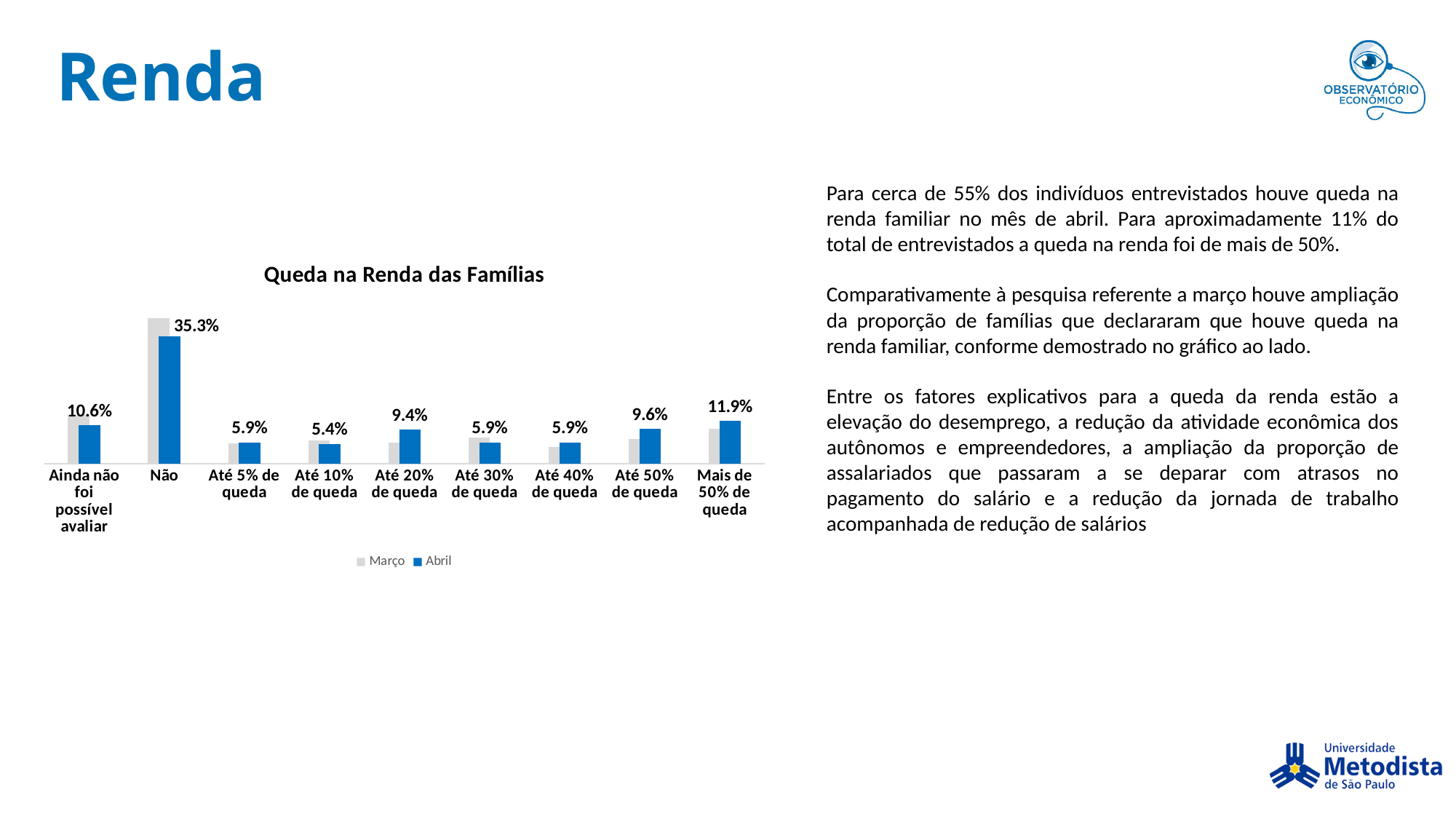
Which category has the lowest Abril value? Até 10% de queda Which has a larger Abril value: "Até 50% de queda" or "Até 20% de queda"? Até 50% de queda How many categories are shown on the x axis of the chart? 9 What kind of chart is shown on the slide? Bar chart What is the difference between the Abril values for "Não" and "Mais de 50% de queda"? 23.4% Which series is shown in blue in the chart? Abril What is the Abril value for "Até 20% de queda"? 9.4% Which category has the highest Abril value? Não What is the Abril value for "Mais de 50% de queda"? 11.9% What is the Abril value for "Não" in the chart "Queda na Renda das Famílias"? 35.3% What is the Abril value for "Ainda não foi possível avaliar"? 10.6% How many series does the chart legend list? 2